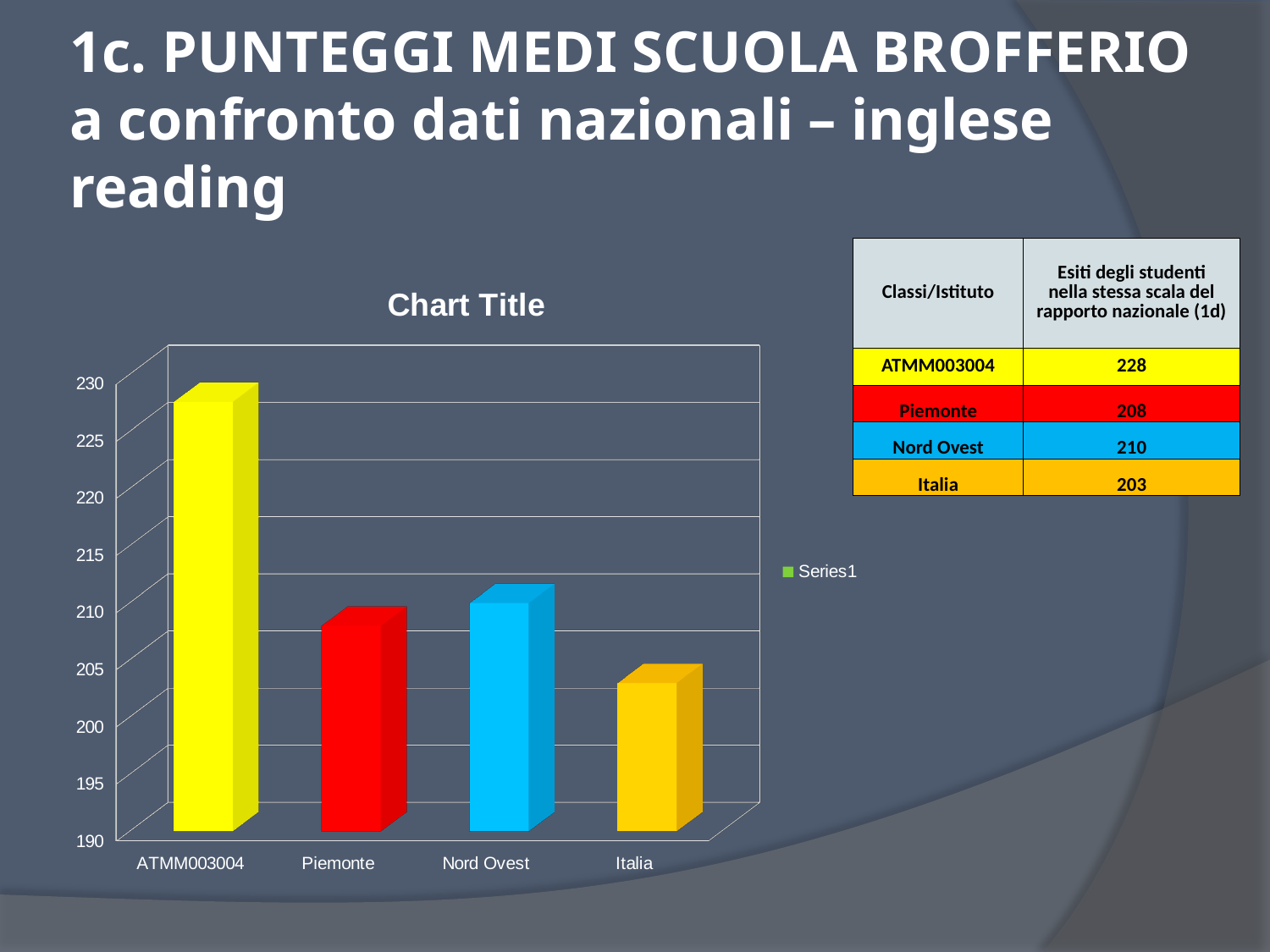
How many series does the chart legend list? 1 Which is larger, the value for Piemonte or the value for Nord Ovest? Nord Ovest What is the value for Piemonte? 208 What is the difference between the values for ATMM003004 and Italia? 25 What kind of chart is shown on the slide? bar chart What is the value for Italia? 203 What is the value for Nord Ovest? 210 Which category has the highest value? ATMM003004 Is the value for Italia greater or less than 205? less Which category has the lowest value? Italia How many categories are shown on the x axis of the chart? 4 What is the value for ATMM003004? 228